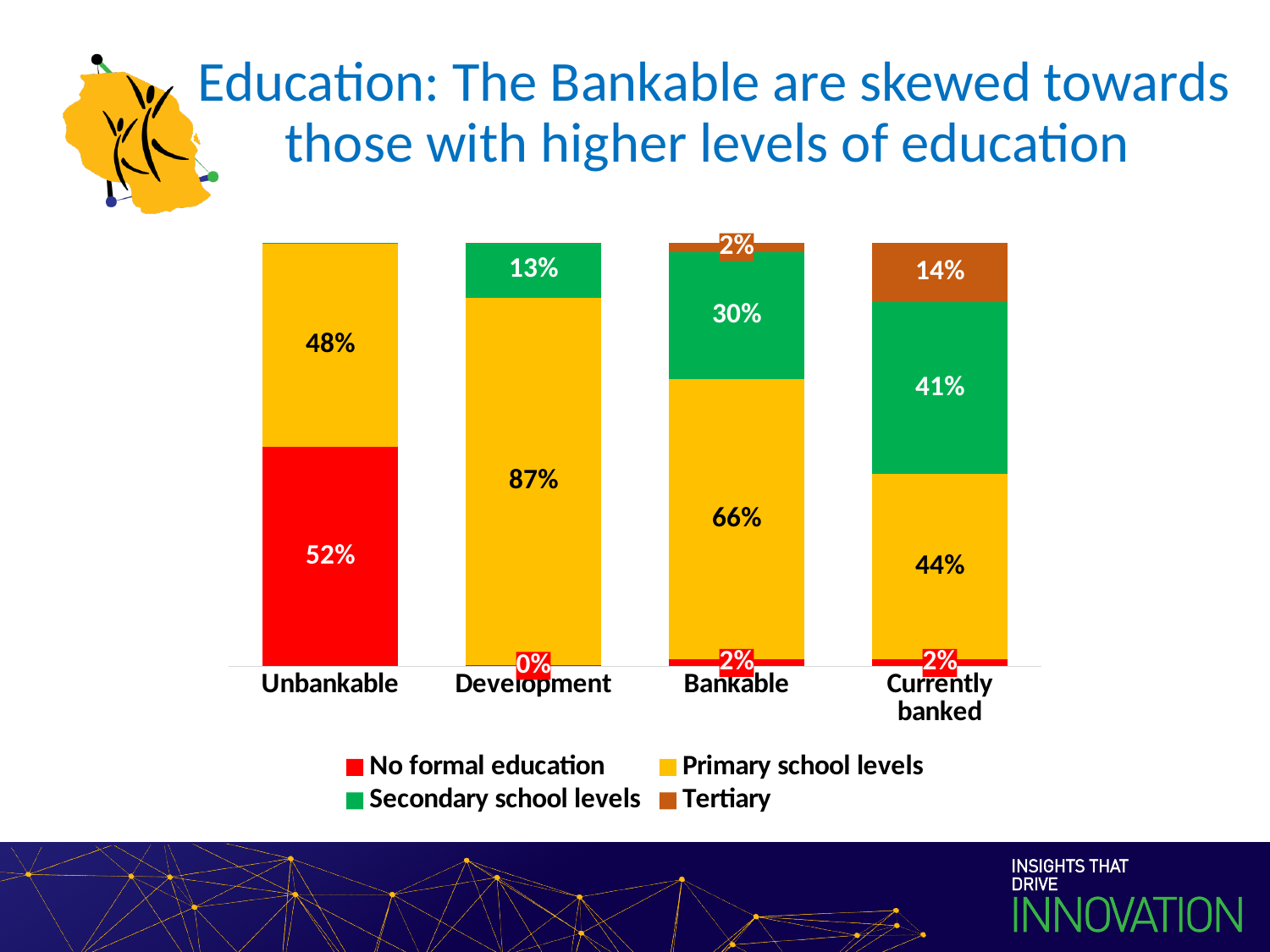
Which group has the highest Primary school levels value? Development What percentage of the Unbankable group has no formal education? 52% Which group has the highest No formal education value? Unbankable How many groups are shown on the x axis? 4 What is the difference between the Secondary school levels values for Currently banked and Bankable? 11% What is the Secondary school levels value for the Bankable group? 30% What kind of chart is shown on the slide? Stacked bar chart Is the Primary school levels value larger for Bankable or for Currently banked? Bankable What is the Primary school levels value for the Development group? 87% How many series does the legend list? 4 Which colour represents Tertiary in the legend? Brown What is the Tertiary value for the Currently banked group? 14%